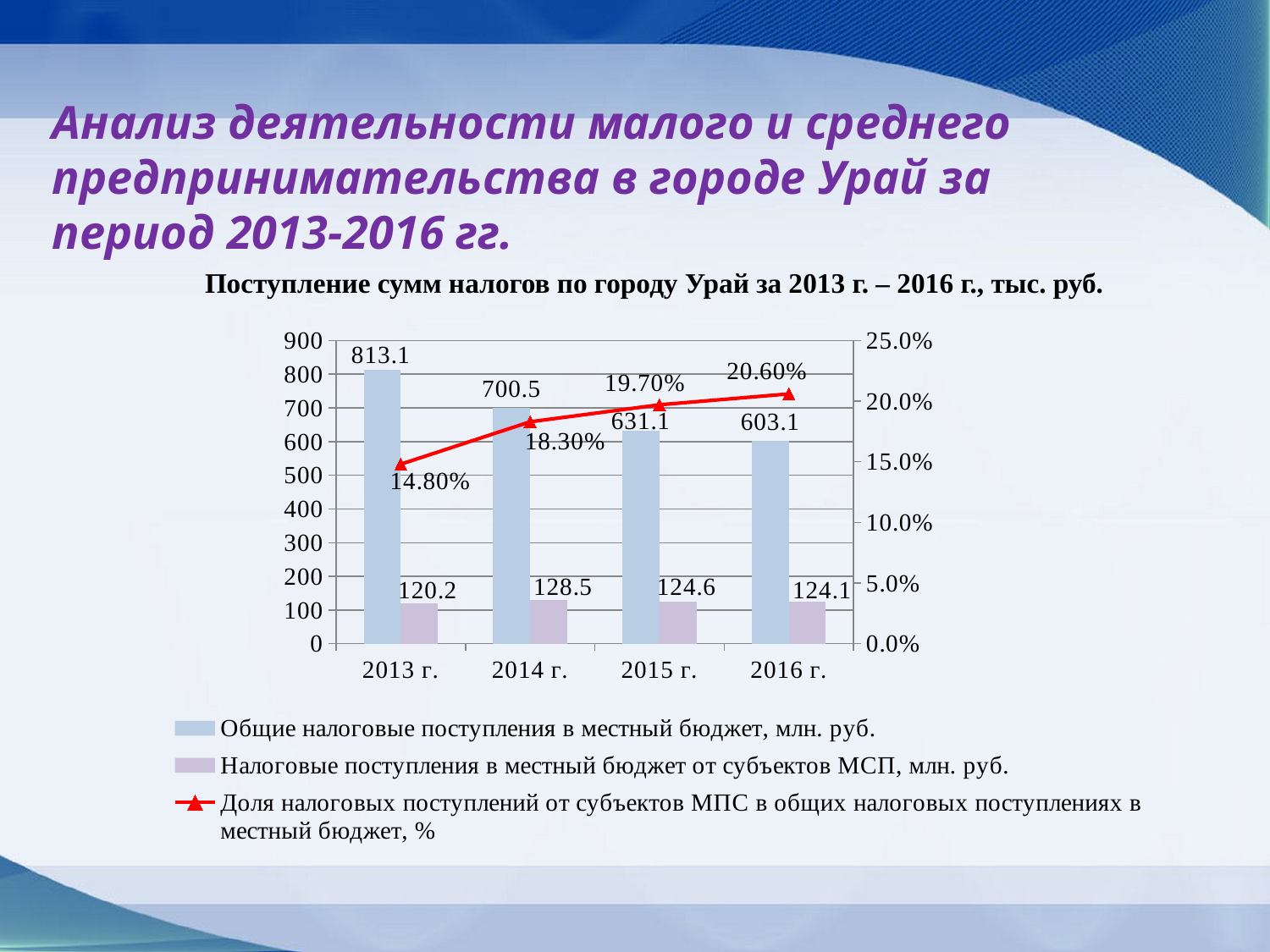
Does the share of tax revenue from SME entities (Доля налоговых поступлений) rise or fall from 2013 г. to 2016 г.? rise What colour is the line showing the share of tax revenue from SME entities (Доля налоговых поступлений)? red What is the difference between total tax revenue (Общие налоговые поступления) in 2013 г. and 2016 г.? 210 How many series does the legend list? 3 In which year is total tax revenue to the local budget (Общие налоговые поступления) the lowest? 2016 г. How many years are shown on the x axis of the chart? 4 What is the value of tax revenue from SME entities (Налоговые поступления от субъектов МСП) for 2014 г.? 128.5 What is the share of tax revenue from SME entities (Доля налоговых поступлений) in 2016 г.? 20.60% In which year is the share of tax revenue from SME entities (Доля налоговых поступлений) the lowest? 2013 г. What is the value of total tax revenue to the local budget (Общие налоговые поступления) for 2013 г.? 813.1 In which year is total tax revenue to the local budget (Общие налоговые поступления) the highest? 2013 г. Which is larger: tax revenue from SME entities (Налоговые поступления от субъектов МСП) in 2014 г. or in 2013 г.? 2014 г.